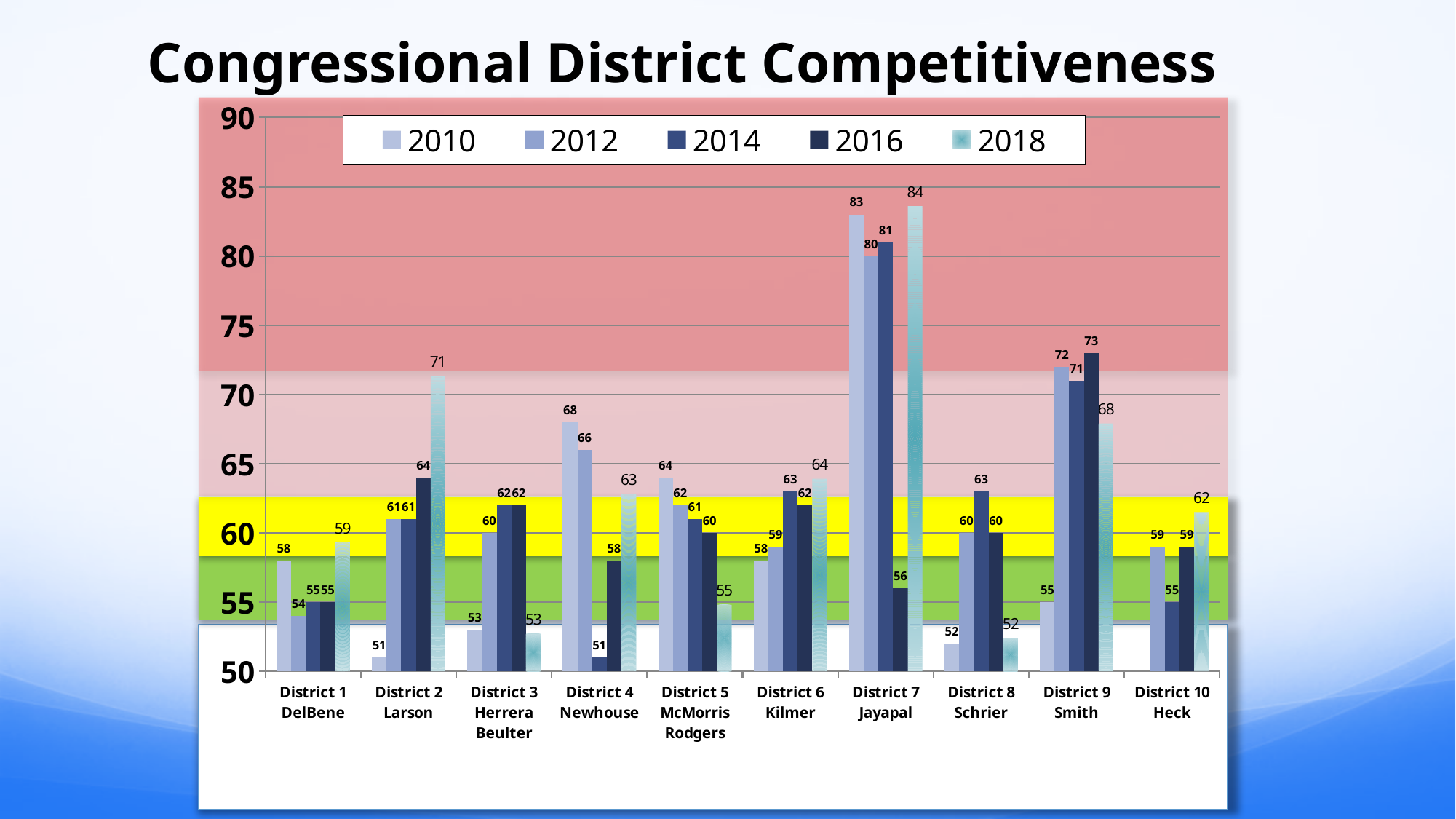
What kind of chart is shown on the slide? bar chart Which district has the highest 2018 value? District 7 Jayapal Which district has the lowest 2010 value? District 2 Larson What is the 2010 value for District 5 McMorris Rodgers? 64 How many districts are shown on the x axis? 10 What is the difference between the 2018 and 2010 values for District 2 Larson? 20 What is the title of the chart? Congressional District Competitiveness Which is larger, the 2010 value for District 4 Newhouse or the 2010 value for District 9 Smith? District 4 Newhouse Do the values for District 2 Larson rise or fall from 2010 to 2018? rise What is the 2016 value for District 9 Smith? 73 How many series does the legend list? 5 What is the 2018 value for District 7 Jayapal? 84